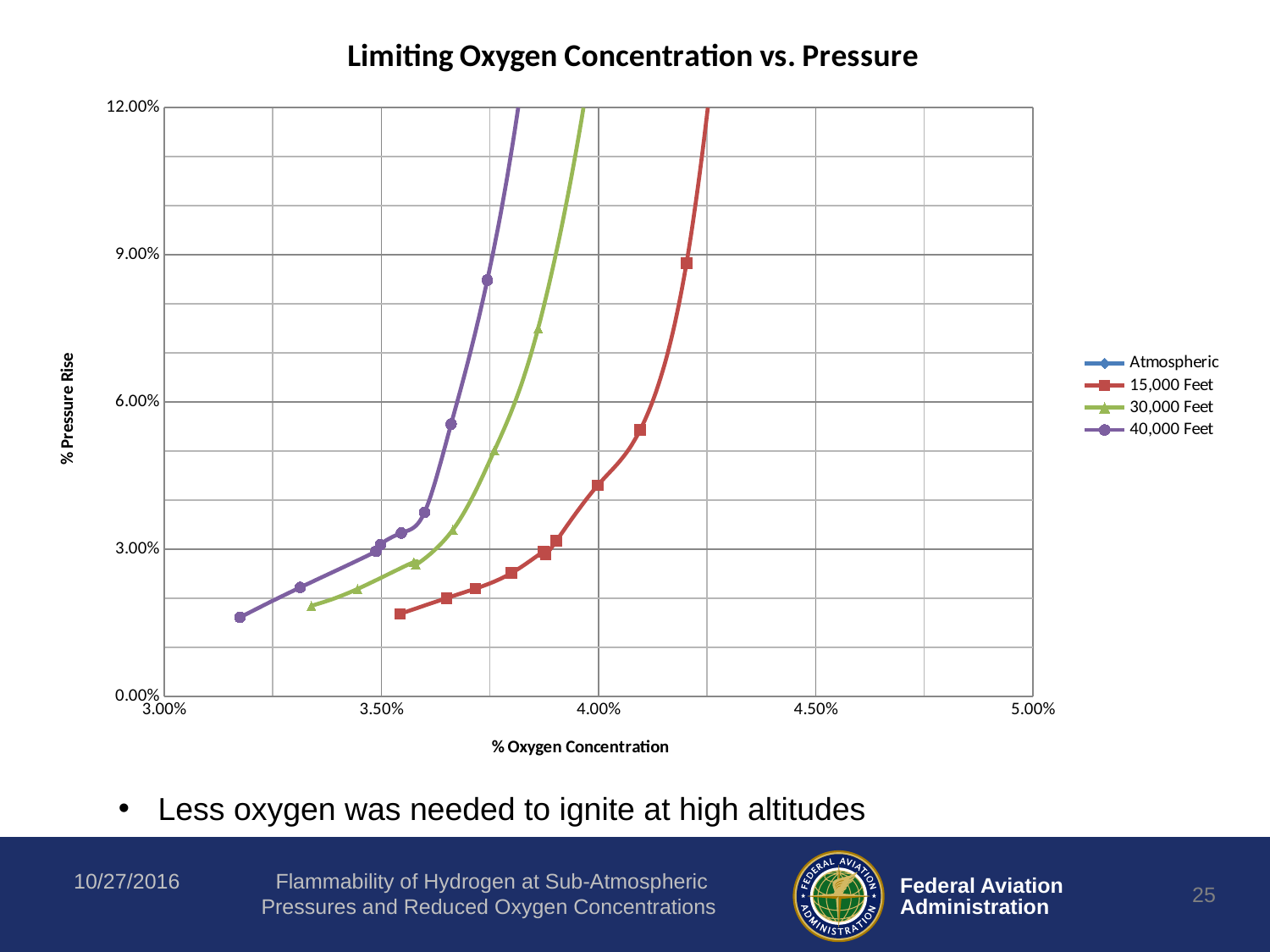
What kind of chart is shown on the slide? line chart Which series has the lowest oxygen concentration at its lowest plotted point, 15,000 Feet or 40,000 Feet? 40,000 Feet Is the oxygen concentration of the lowest point of the 15,000 Feet series greater or less than 3.50%? greater How many series does the legend list? 4 Which series lies furthest to the left on the chart, reaching a given pressure rise at the lowest oxygen concentration? 40,000 Feet What is the label of the x axis? % Oxygen Concentration For the 15,000 Feet series, does % Pressure Rise rise or fall as % Oxygen Concentration increases? rise Is the pressure rise of the lowest point of the 30,000 Feet series greater or less than 3.00%? less Which plotted series lies furthest to the right on the chart? 15,000 Feet Is the pressure rise of the highest marked point of the 15,000 Feet series greater or less than 6.00%? greater What is the title of the chart? Limiting Oxygen Concentration vs. Pressure